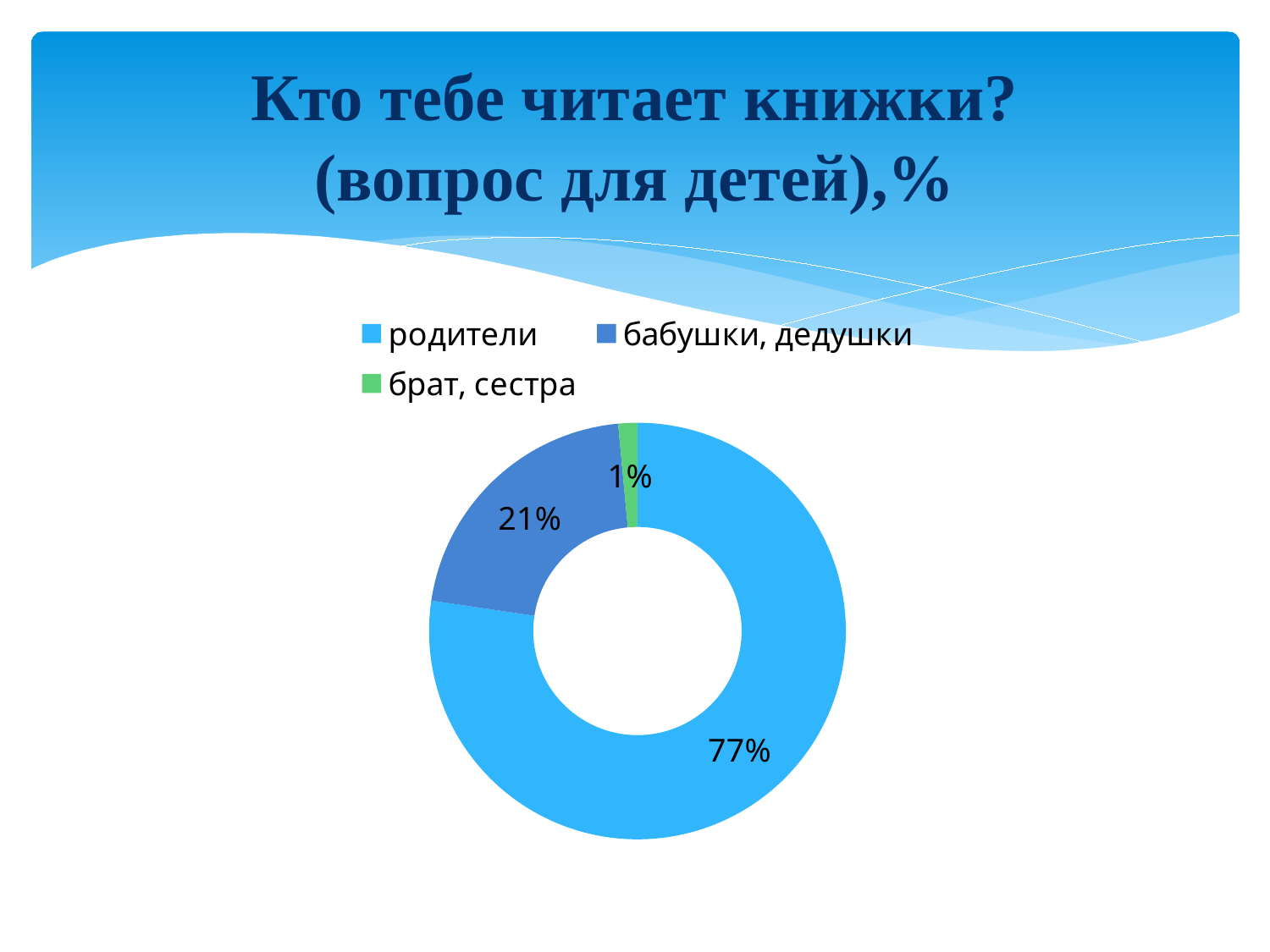
Which category has the smallest share of the chart? брат, сестра How many categories does the chart show? 3 Which category has the largest share of the chart? родители What percentage of the chart is for родители? 77% What percentage of the chart is for брат, сестра? 1% What is the title of the slide? Кто тебе читает книжки? (вопрос для детей),% What is the difference in percentage points between бабушки, дедушки and брат, сестра? 20 What is the difference in percentage points between родители and бабушки, дедушки? 56 What percentage of the chart is for бабушки, дедушки? 21% What colour is the slice for брат, сестра? green Which is larger: the share for бабушки, дедушки or the share for брат, сестра? бабушки, дедушки What kind of chart is shown on the slide? doughnut chart